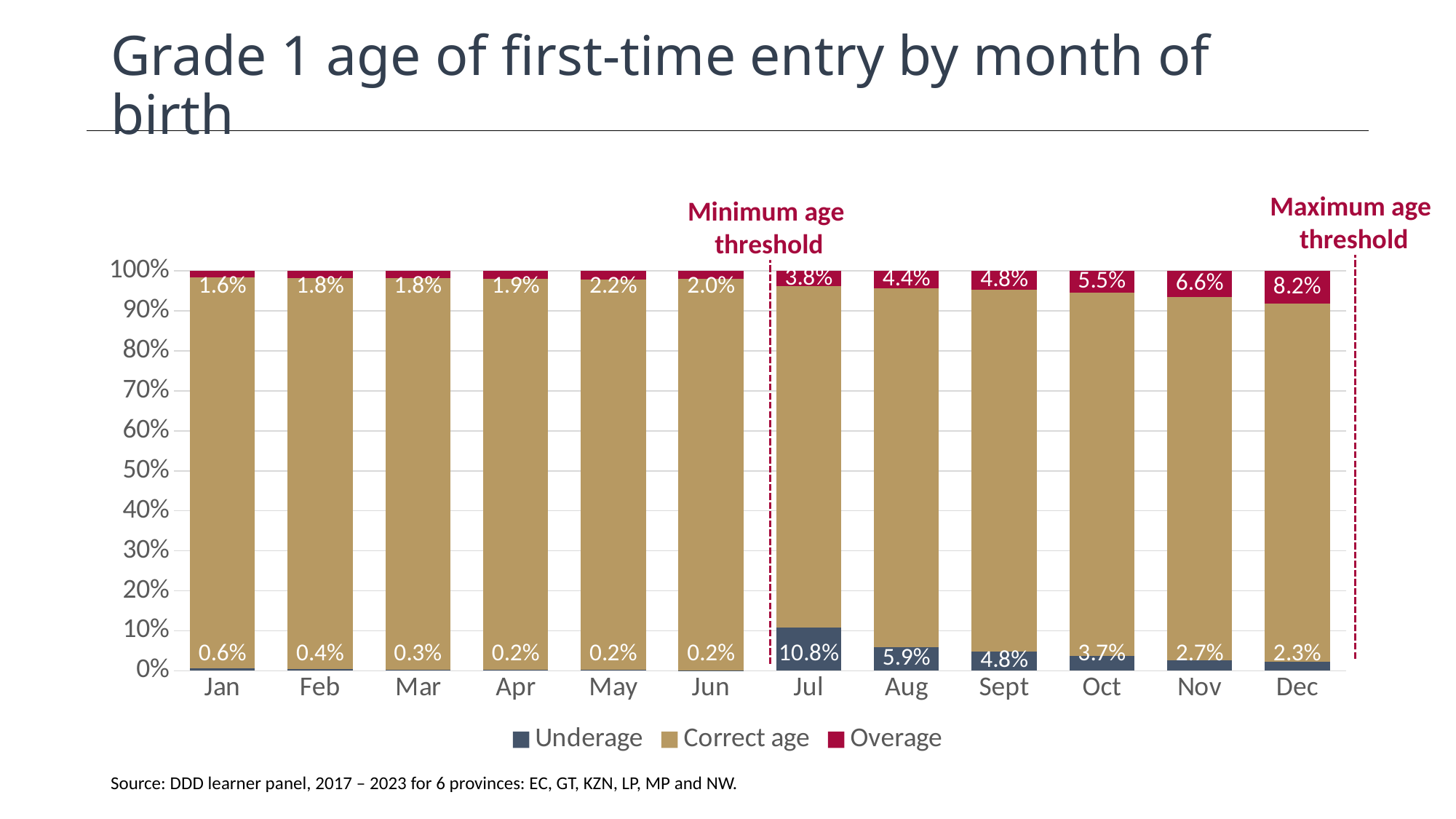
What is the difference between the Overage percentages for Dec and Nov? 1.6% What is the Overage percentage for Dec? 8.2% What is the Underage percentage for Jul? 10.8% What is the Underage percentage for Oct? 3.7% What kind of chart is shown on the slide? Stacked bar chart Which month has the lowest Overage percentage? Jan Which is larger, the Underage percentage for Aug or for Sept? Aug Which month has the highest Overage percentage? Dec How many months are shown on the x axis? 12 Which month has the highest Underage percentage? Jul What is the Overage percentage for Jan? 1.6% How many series does the legend list? 3